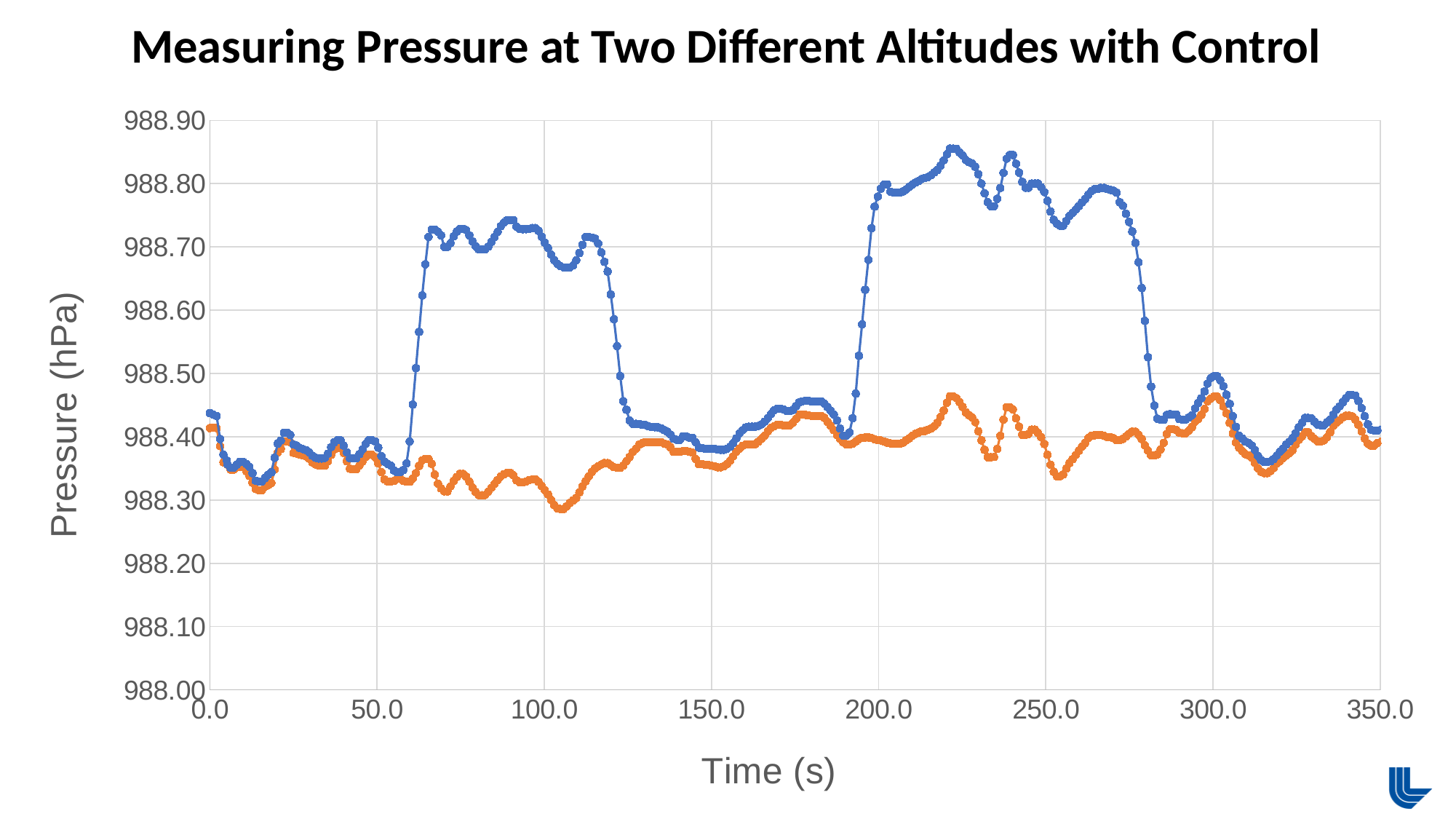
Is the value of the orange series at 220 s greater or less than 988.40? greater What is the label of the y axis? Pressure (hPa) At 100 s, which series has the higher pressure, the blue or the orange? blue Is the value of the blue series at 260 s greater or less than 988.70? greater Does the blue series rise or fall between 60 s and 70 s? rise What is the title of the chart? Measuring Pressure at Two Different Altitudes with Control What kind of chart is shown on the slide? line chart Which series reaches the highest pressure on the chart? blue Does the blue series rise or fall between 275 s and 285 s? fall Is the value of the blue series at 220 s greater or less than 988.80? greater